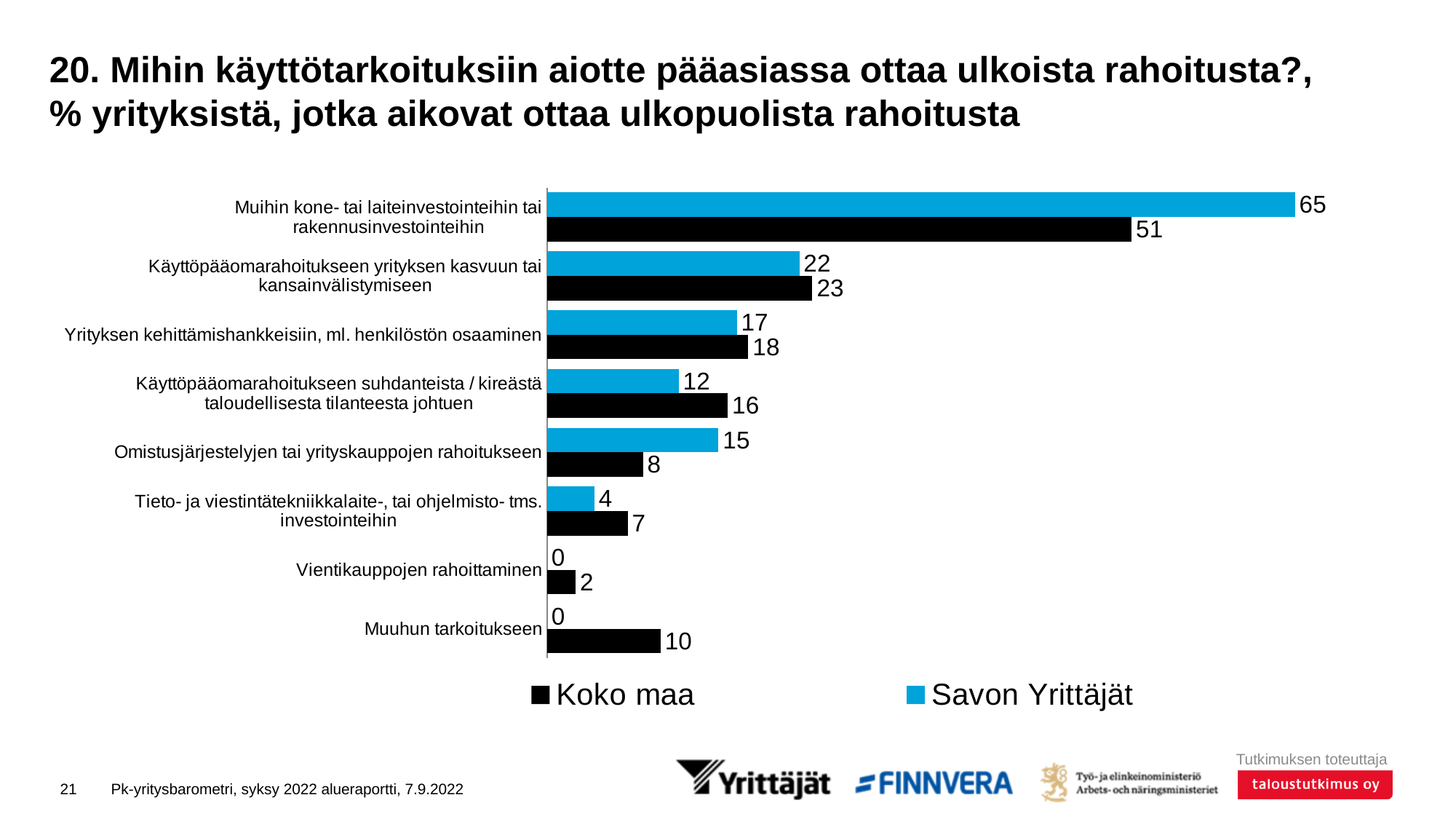
How many categories are shown in the chart? 8 What is the value for Savon Yrittäjät for "Muihin kone- tai laiteinvestointeihin tai rakennusinvestointeihin"? 65 What is the value for Savon Yrittäjät for "Käyttöpääomarahoitukseen suhdanteista / kireästä taloudellisesta tilanteesta johtuen"? 12 Which category has the highest value for Koko maa? Muihin kone- tai laiteinvestointeihin tai rakennusinvestointeihin How many series does the legend list? 2 What is the value for Koko maa for "Muuhun tarkoitukseen"? 10 What is the value for Koko maa for "Omistusjärjestelyjen tai yrityskauppojen rahoitukseen"? 8 What kind of chart is shown on the slide? Bar chart What is the difference between the Savon Yrittäjät and Koko maa values for "Omistusjärjestelyjen tai yrityskauppojen rahoitukseen"? 7 What is the difference between the Savon Yrittäjät and Koko maa values for "Muihin kone- tai laiteinvestointeihin tai rakennusinvestointeihin"? 14 Which category has the lowest value for Koko maa? Vientikauppojen rahoittaminen For "Tieto- ja viestintätekniikkalaite-, tai ohjelmisto- tms. investointeihin", which series has the larger value, Koko maa or Savon Yrittäjät? Koko maa